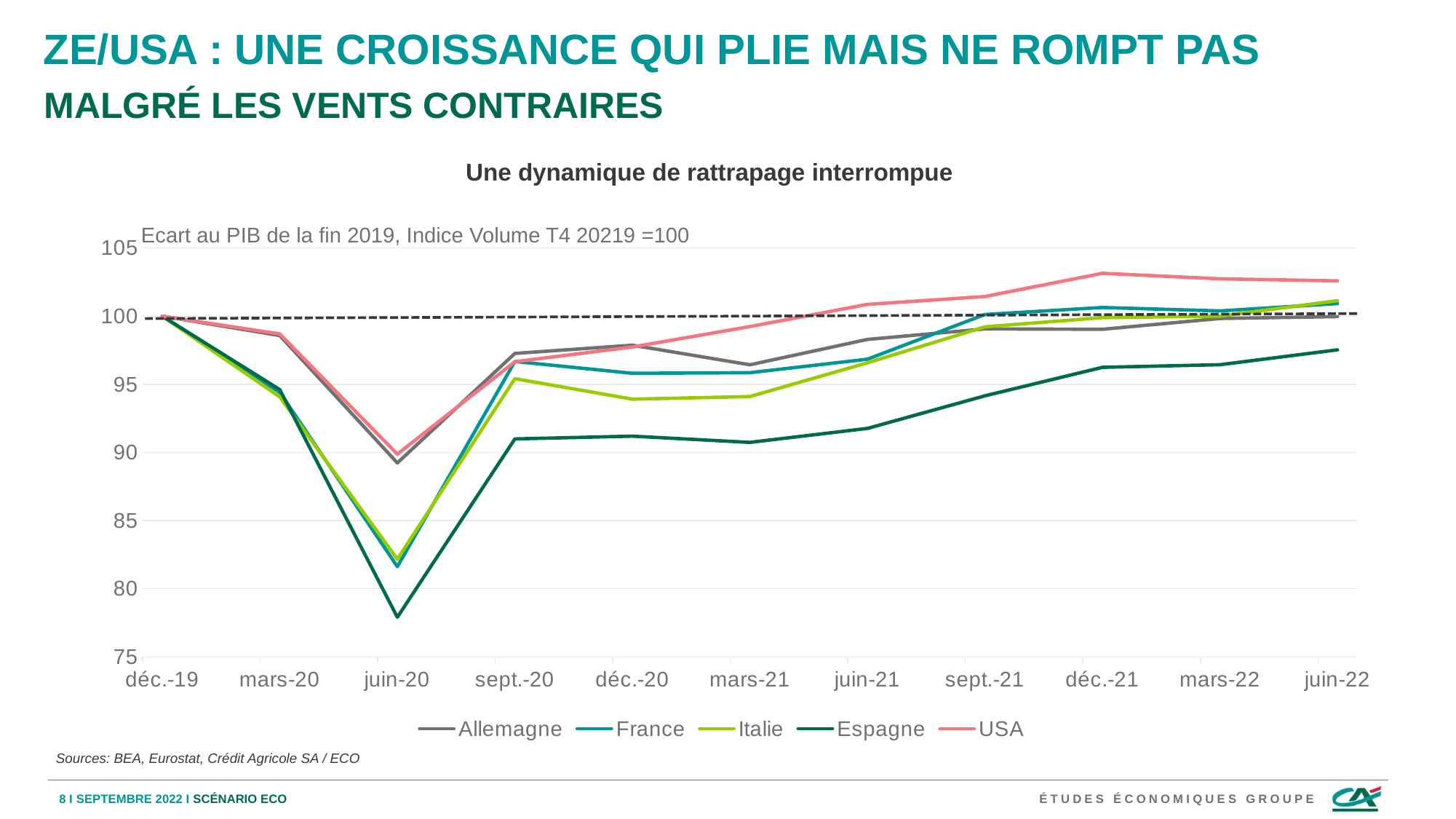
Is the value for Italie at déc.-20 greater or less than 95? less Which series has the lowest value at juin-22? Espagne How many series does the legend list? 5 Which series has the lowest value at juin-20? Espagne How many dates are labelled along the x axis? 11 Is the value for USA at déc.-21 greater or less than 100? greater At juin-20, which is larger: the value for USA or the value for Espagne? USA What is the title of the chart? Une dynamique de rattrapage interrompue What kind of chart is shown on the slide? line chart Does the Espagne line rise or fall between juin-20 and juin-22? rise Is the value for Espagne at juin-20 greater or less than 80? less Which series has the highest value at juin-22? USA